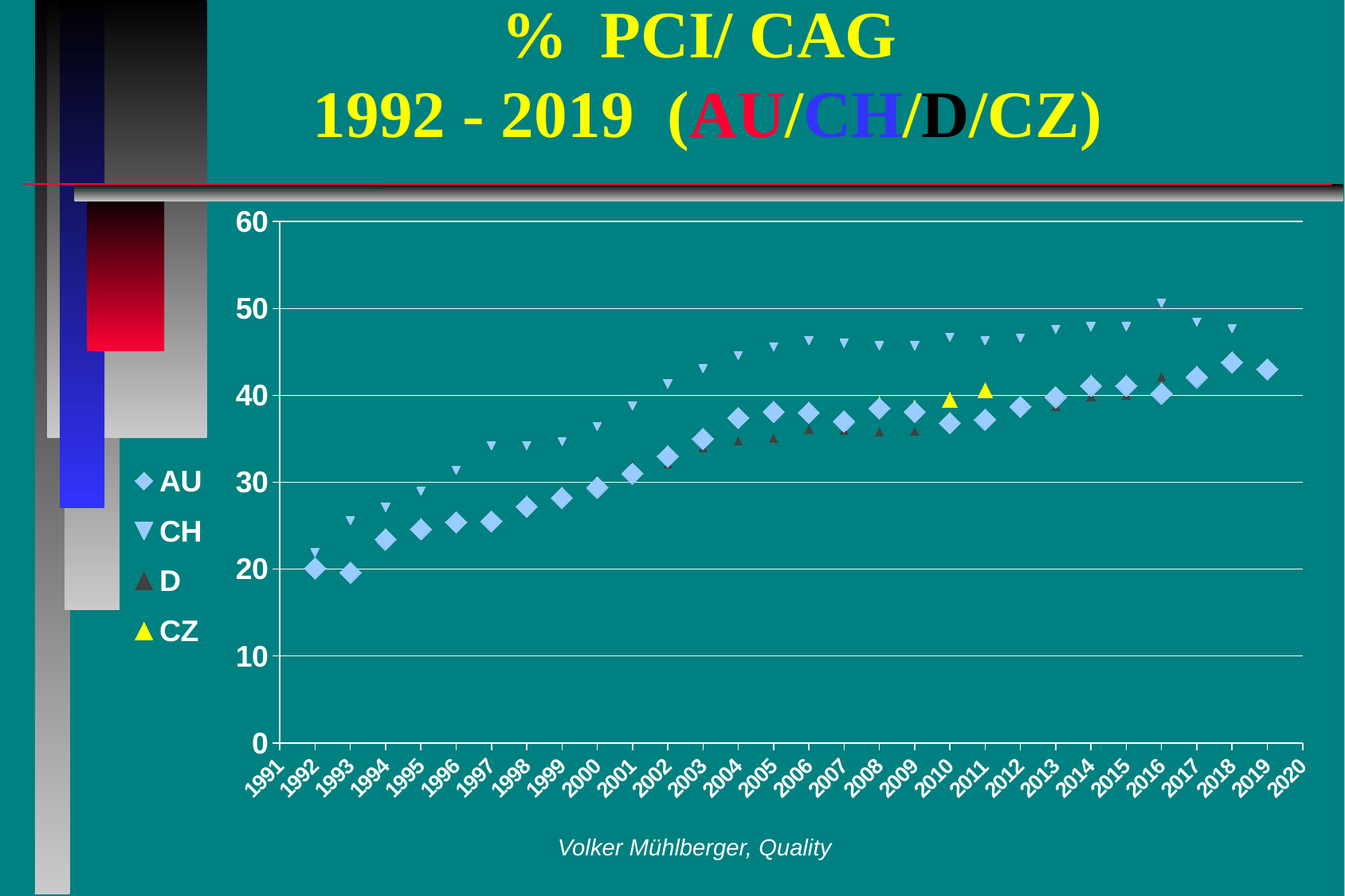
What kind of chart is shown on the slide? scatter chart How many series does the legend list? 4 In 2006, which series has the higher value, CH or AU? CH In 2005, which series has the higher value, AU or D? AU What is the title of the chart? % PCI/ CAG 1992 - 2019 (AU/CH/D/CZ) Which series are listed in the legend? AU, CH, D, CZ Do the AU values generally rise or fall from 1992 to 2019? rise Is the D value for 2003 greater or less than 30? greater Is the CH value for 2006 greater or less than 40? greater Is the AU value for 2019 greater or less than 40? greater